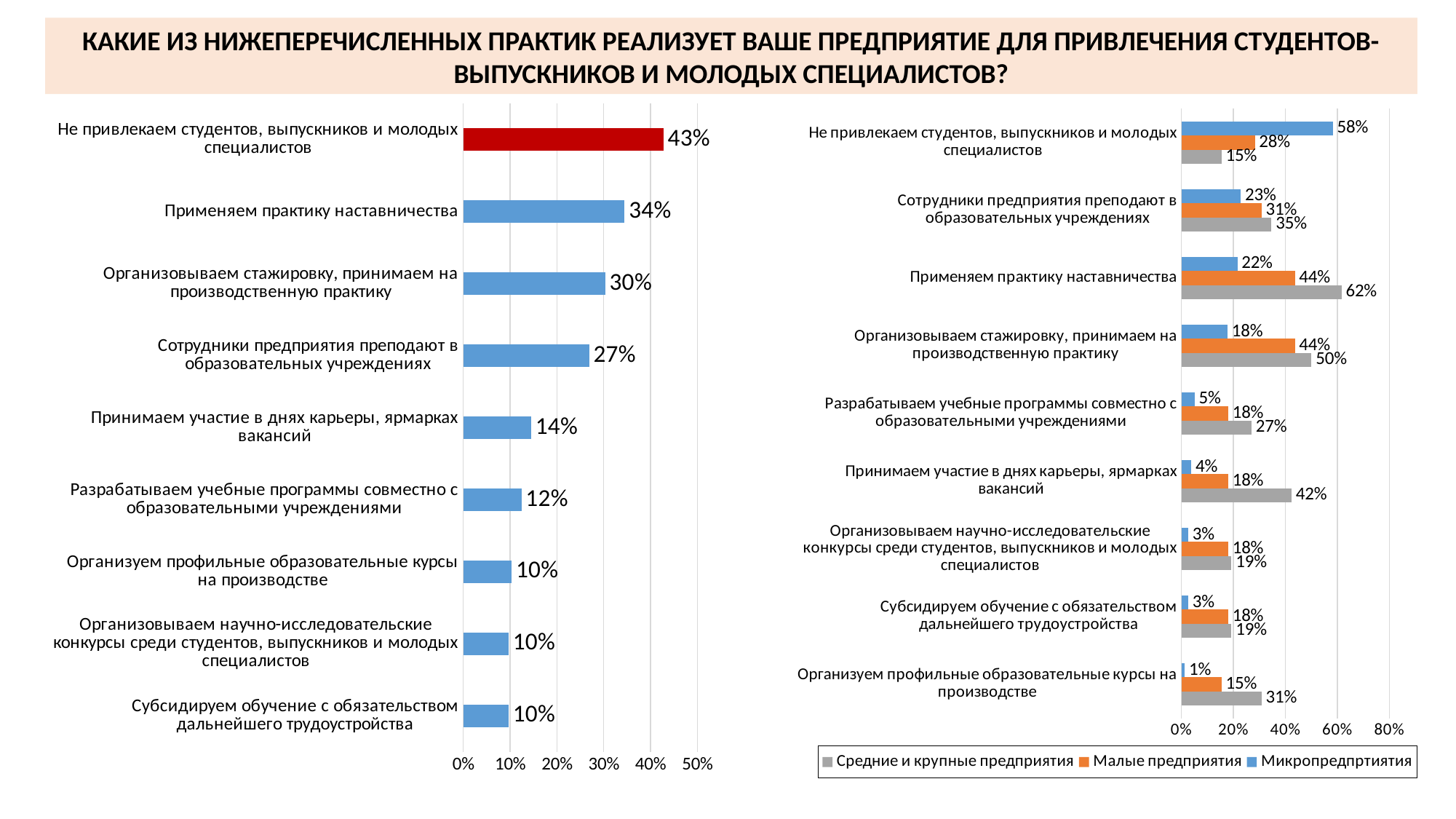
In the right chart, which is larger for "Принимаем участие в днях карьеры, ярмарках вакансий": "Малые предприятия" or "Средние и крупные предприятия"? Средние и крупные предприятия In the right chart, what is the value for "Микропредпртиятия" in "Не привлекаем студентов, выпускников и молодых специалистов"? 58% In the right chart, which colour represents "Малые предприятия"? Orange In the left chart, which category has the highest value? Не привлекаем студентов, выпускников и молодых специалистов In the right chart, what is the difference between "Средние и крупные предприятия" and "Микропредпртиятия" for "Организовываем стажировку, принимаем на производственную практику"? 32% In the right chart, what is the value for "Средние и крупные предприятия" in "Применяем практику наставничества"? 62% In the right chart, which category has the lowest value for "Микропредпртиятия"? Организуем профильные образовательные курсы на производстве In the left chart, what kind of chart is it? Bar chart In the right chart, how many series does the legend list? 3 In the left chart, how many categories are shown? 9 In the left chart, what is the difference between "Организовываем стажировку, принимаем на производственную практику" and "Принимаем участие в днях карьеры, ярмарках вакансий"? 16% In the left chart, what is the value for "Применяем практику наставничества"? 34%